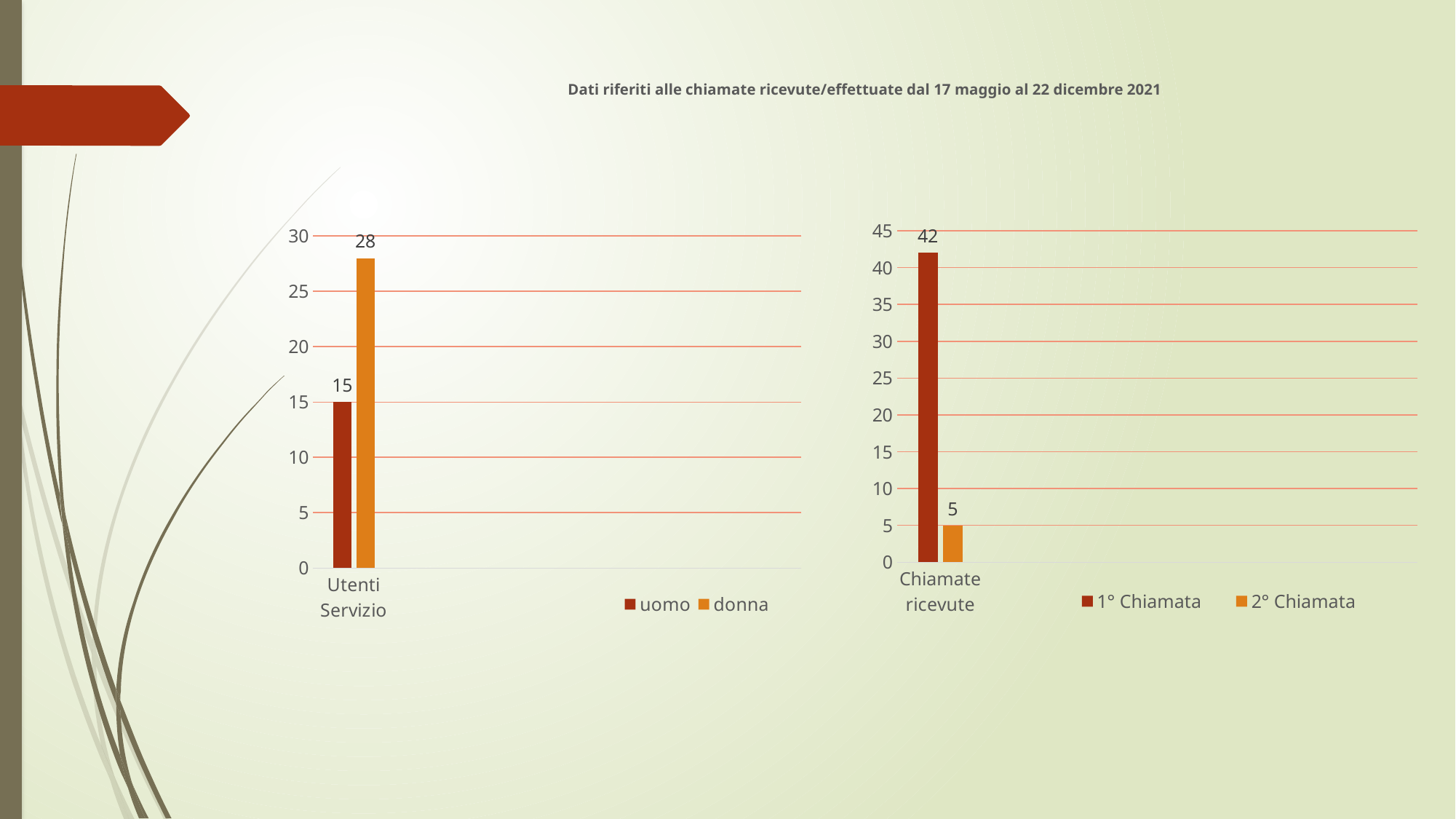
In the left chart (Utenti Servizio), what is the value for donna? 28 In the right chart (Chiamate ricevute), which series has the lower value? 2° Chiamata In the right chart (Chiamate ricevute), what is the value for 1° Chiamata? 42 In the left chart (Utenti Servizio), what is the difference between the donna and uomo values? 13 In the right chart (Chiamate ricevute), what is the difference between the 1° Chiamata and 2° Chiamata values? 37 In the right chart (Chiamate ricevute), is the value for 1° Chiamata greater or less than 40? greater In the left chart (Utenti Servizio), which series has the higher value, uomo or donna? donna In the left chart (Utenti Servizio), how many series does the legend list? 2 What kind of chart is the right chart (Chiamate ricevute)? bar chart What is the title text shown above the charts on the slide? Dati riferiti alle chiamate ricevute/effettuate dal 17 maggio al 22 dicembre 2021 In the left chart (Utenti Servizio), what is the value for uomo? 15 In the right chart (Chiamate ricevute), what is the value for 2° Chiamata? 5